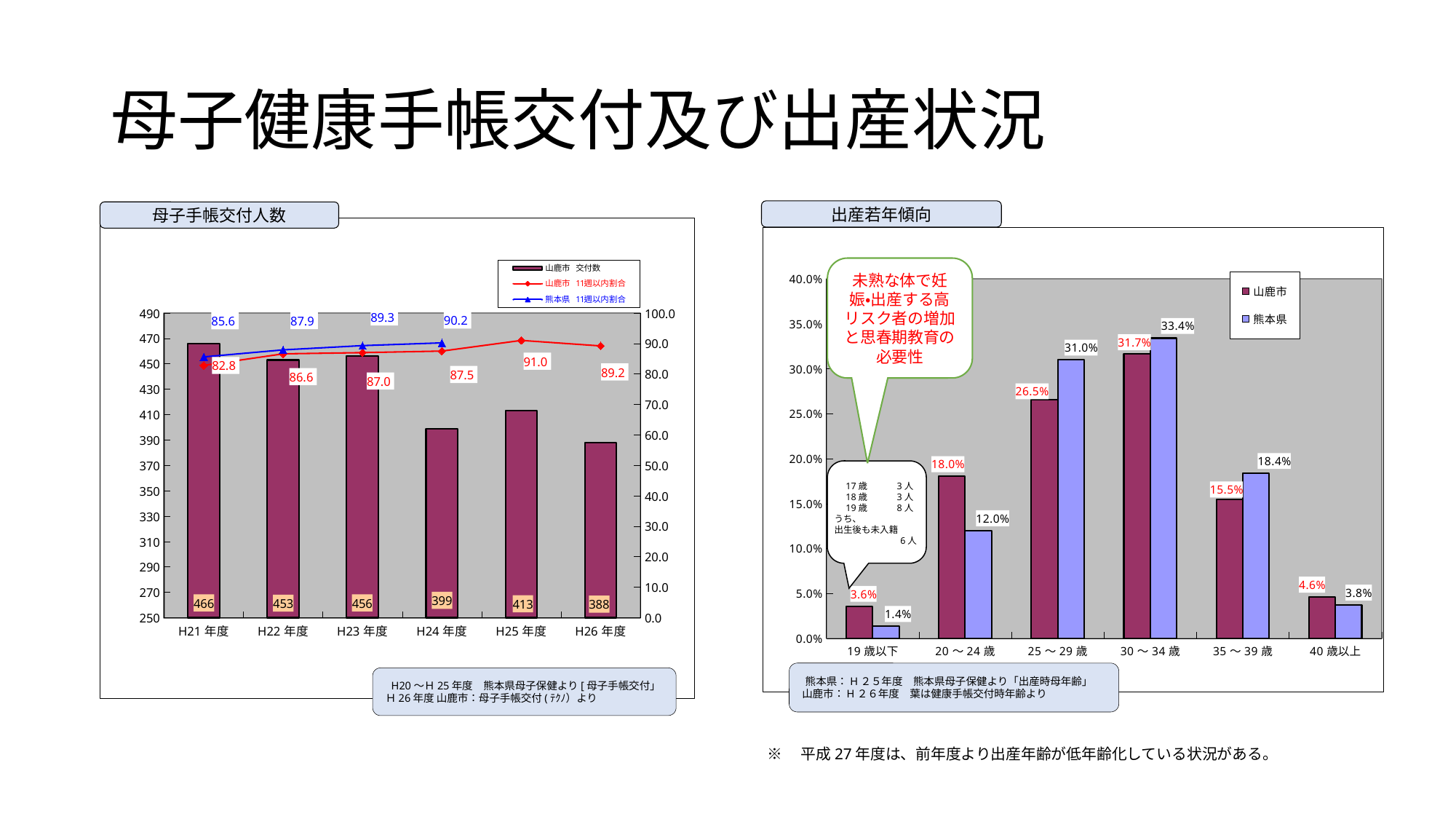
In the 母子手帳交付人数 chart on the left, what is the difference in 山鹿市 交付数 between H23年度 and H24年度? 57 In the 母子手帳交付人数 chart on the left, what is the 熊本県 11週以内割合 value for H24年度? 90.2 In the 出産若年傾向 chart on the right, which is larger for 25～29歳, 山鹿市 or 熊本県? 熊本県 In the 母子手帳交付人数 chart on the left, what is the 山鹿市 11週以内割合 value for H25年度? 91.0 In the 母子手帳交付人数 chart on the left, how many series does the legend list? 3 In the 母子手帳交付人数 chart on the left, what is the 山鹿市 交付数 value for H21年度? 466 In the 出産若年傾向 chart on the right, what is the 山鹿市 value for 20～24歳? 18.0% In the 母子手帳交付人数 chart on the left, which year has the lowest 山鹿市 交付数? H26年度 In the 出産若年傾向 chart on the right, what is the 熊本県 value for 30～34歳? 33.4% In the 出産若年傾向 chart on the right, which age group has the highest 山鹿市 value? 30～34歳 In the 出産若年傾向 chart on the right, how many age categories are shown on the x axis? 6 In the 母子手帳交付人数 chart on the left, which year has the highest 山鹿市 交付数? H21年度